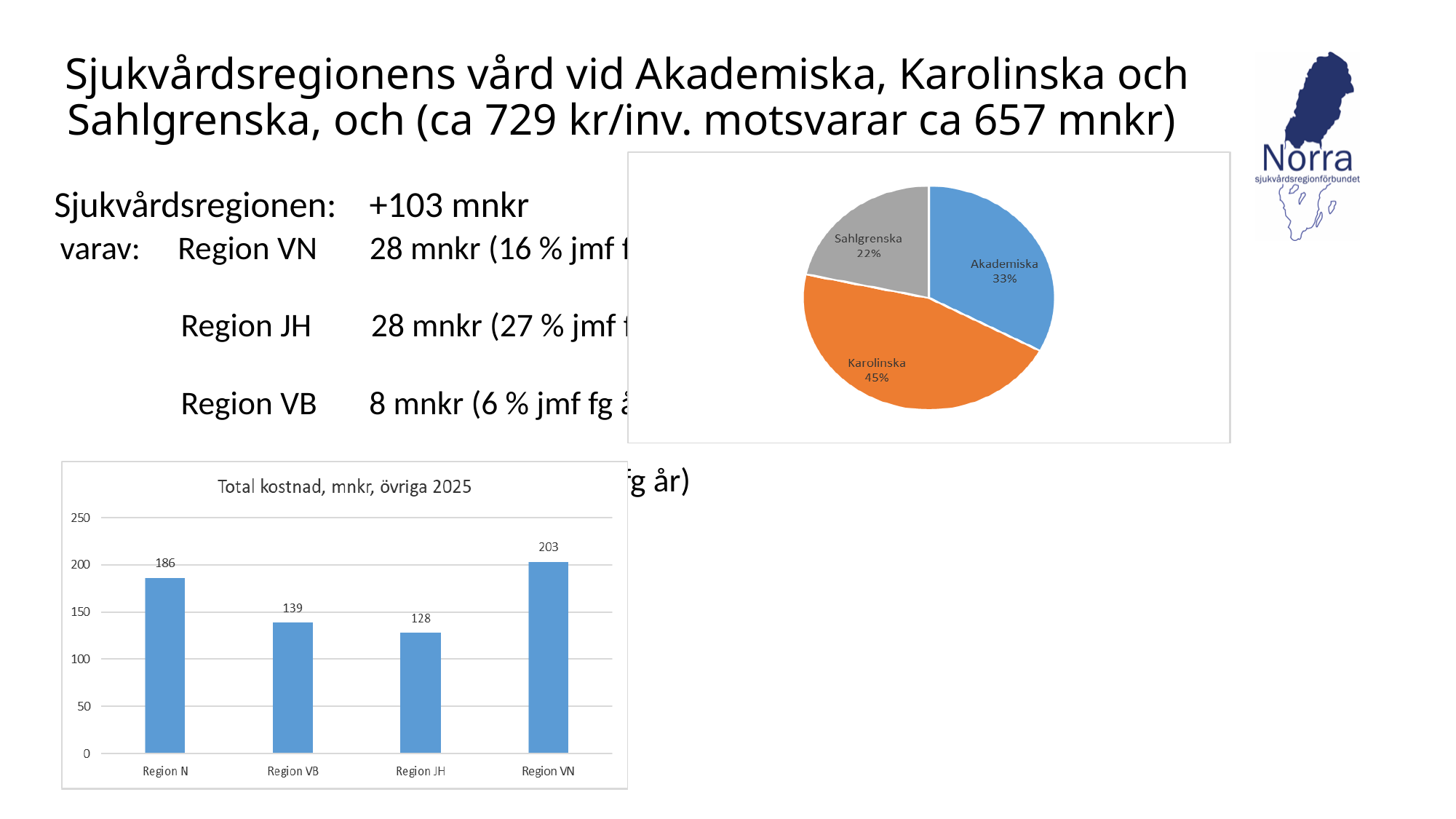
In the pie chart on the right, what share does Karolinska have? 45% In the pie chart on the right, how many slices are there? 3 What kind of chart is the chart titled 'Total kostnad, mnkr, övriga 2025'? bar chart In the bar chart 'Total kostnad, mnkr, övriga 2025', how many regions are shown? 4 In the bar chart 'Total kostnad, mnkr, övriga 2025', which is larger, Region N or Region VB? Region N In the pie chart on the right, what share does Sahlgrenska have? 22% In the bar chart 'Total kostnad, mnkr, övriga 2025', which region has the highest value? Region VN In the pie chart on the right, which slice is the largest? Karolinska In the bar chart 'Total kostnad, mnkr, övriga 2025', which region has the lowest value? Region JH In the bar chart 'Total kostnad, mnkr, övriga 2025', what is the value for Region N? 186 In the bar chart 'Total kostnad, mnkr, övriga 2025', what is the value for Region JH? 128 In the bar chart 'Total kostnad, mnkr, övriga 2025', what is the difference between Region VN and Region VB? 64